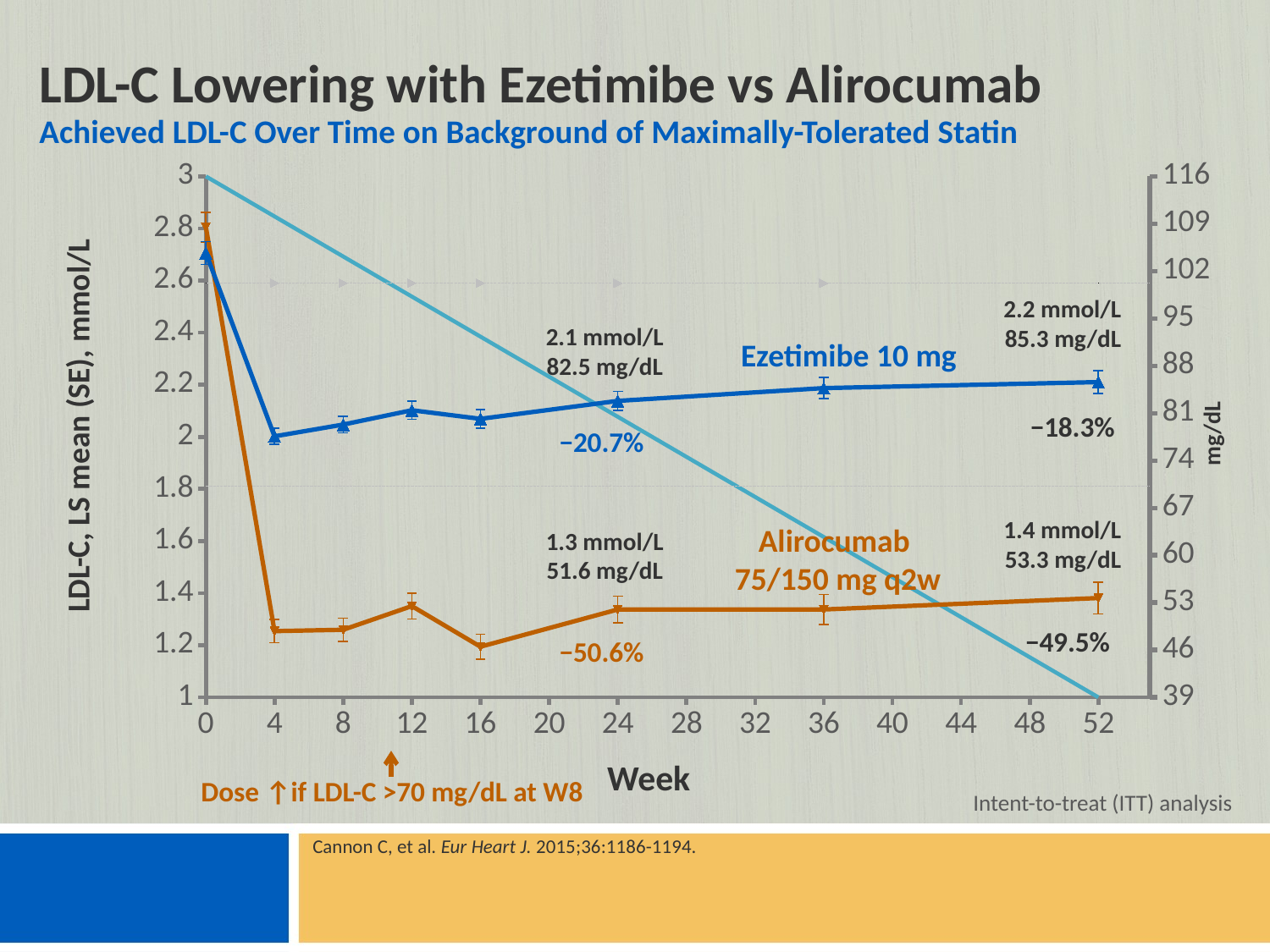
What percentage change in LDL-C is shown for Ezetimibe at week 52? −18.3% What is the LDL-C value in mmol/L for Ezetimibe 10 mg at week 24? 2.1 mmol/L Is the LDL-C value for Alirocumab at week 4 greater or less than 1.4 mmol/L? less What is the label of the x axis? Week What is the LDL-C value in mmol/L for Alirocumab 75/150 mg q2w at week 52? 1.4 mmol/L What is the LDL-C value in mg/dL for Ezetimibe 10 mg at week 52? 85.3 mg/dL What percentage change in LDL-C is shown for Alirocumab at week 24? −50.6% What is the LDL-C value in mg/dL for Alirocumab 75/150 mg q2w at week 24? 51.6 mg/dL What is the difference in mg/dL between Ezetimibe and Alirocumab LDL-C at week 24? 30.9 mg/dL How many treatment series are plotted on the chart? 2 What type of chart is shown on the slide? line chart Which treatment has the lower LDL-C at week 52, Ezetimibe 10 mg or Alirocumab 75/150 mg q2w? Alirocumab 75/150 mg q2w